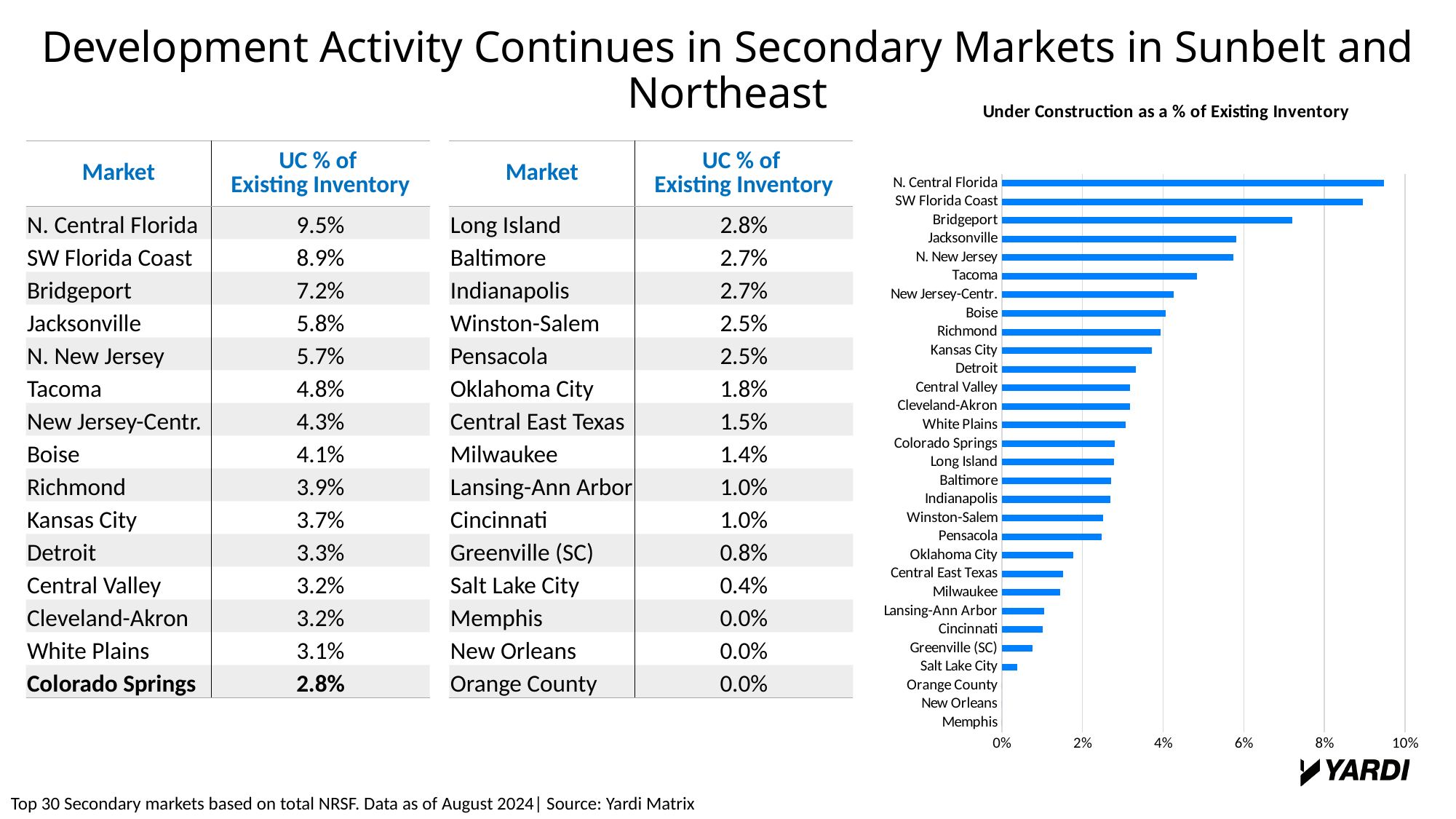
Which market has the highest under construction percentage of existing inventory? N. Central Florida How many markets are shown in the chart? 30 Is the value for Jacksonville greater or less than 4%? greater How many markets show 0.0% under construction as a percentage of existing inventory? 3 What is the title of the chart on the slide? Under Construction as a % of Existing Inventory What is the under construction percentage of existing inventory for Kansas City? 3.7% Which has a higher under construction percentage, Tacoma or Boise? Tacoma What kind of chart is shown on the slide? Bar chart What is the difference in percentage points between N. Central Florida and SW Florida Coast? 0.6 percentage points Do the bar values rise or fall going from the top of the chart to the bottom? Fall What is the under construction percentage of existing inventory for Bridgeport? 7.2% What is the under construction percentage of existing inventory for Salt Lake City? 0.4%